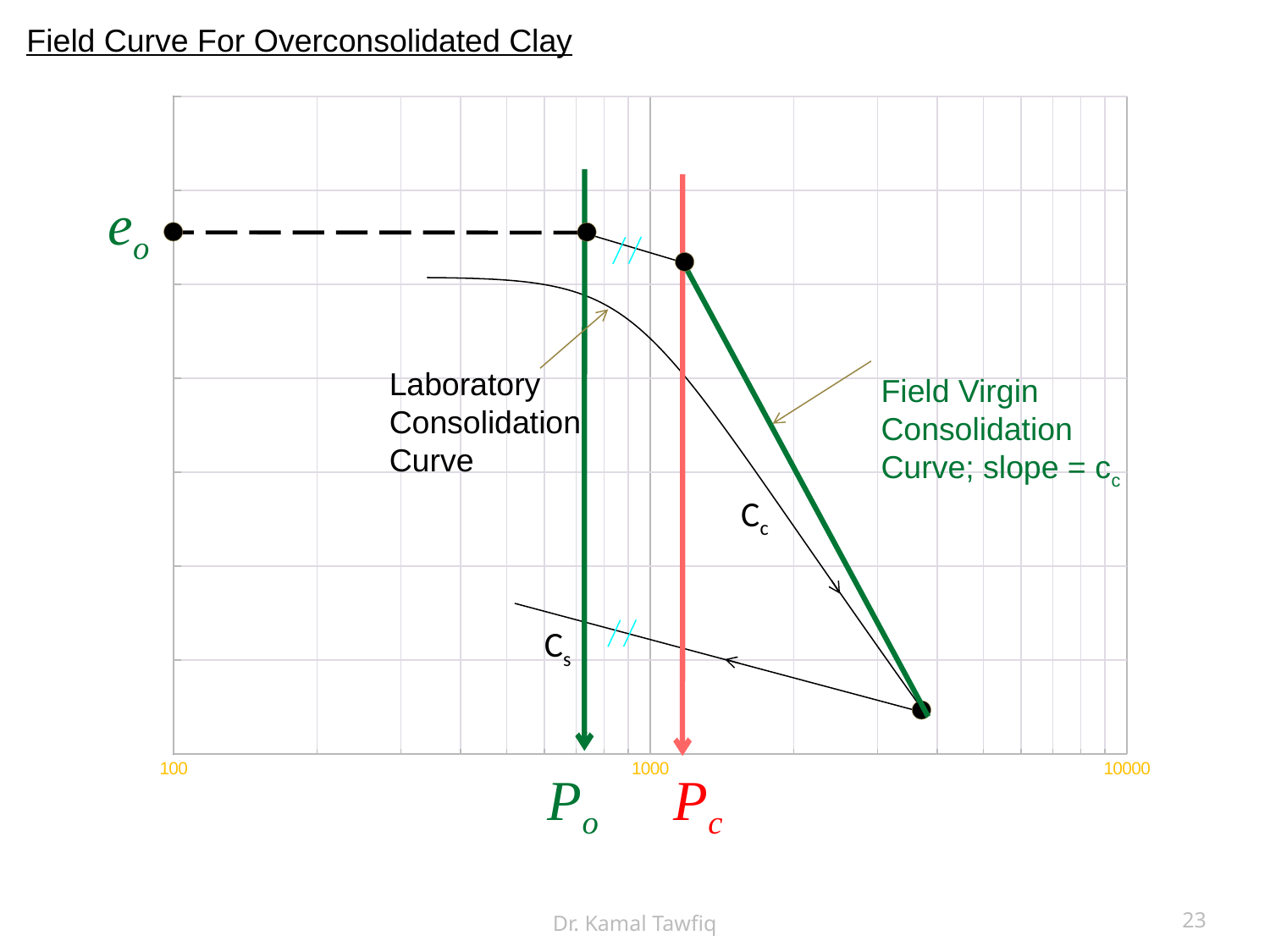
What kind of chart is shown on the slide? line chart Is the value of Po on the x axis greater or less than 1000? less What is the smallest value labeled on the x axis? 100 According to the annotation, what is the slope of the Field Virgin Consolidation Curve called? cc What is the largest value labeled on the x axis? 10000 How many numeric tick labels are shown on the x axis? 3 Which is larger on the x axis, Po or Pc? Pc Is the value of Pc on the x axis greater or less than 1000? greater What is the title of the chart on the slide? Field Curve For Overconsolidated Clay Along the Field Virgin Consolidation Curve, does the void ratio rise or fall as pressure increases along the x axis? fall Is the value of Pc on the x axis greater or less than 10000? less